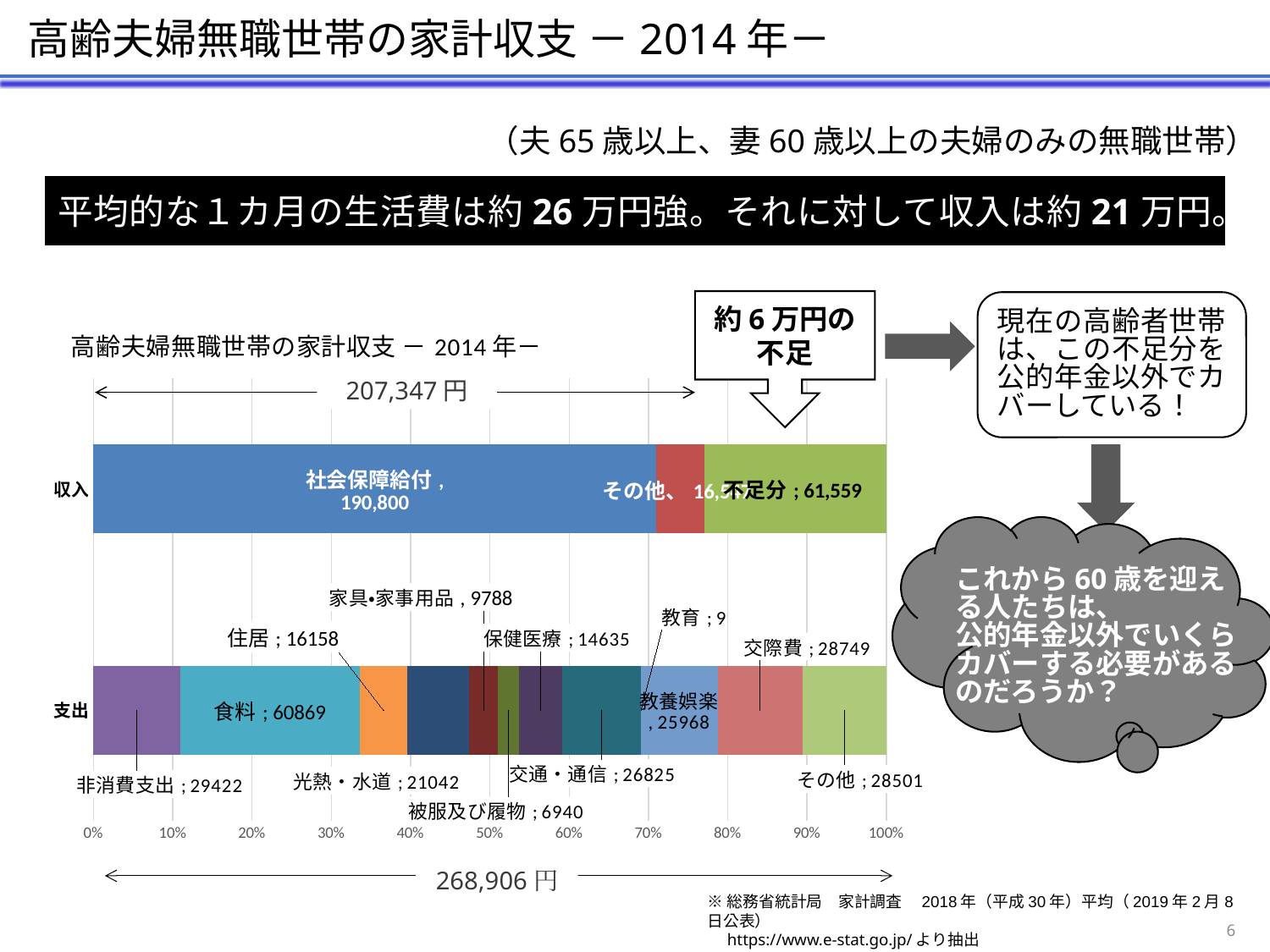
What is the value of 住居 in the 支出 bar? 16158 What total amount is shown for the 収入 bar? 207,347 円 What is the value of 不足分 in the 収入 bar? 61,559 What is the value of 交際費 in the 支出 bar? 28749 What is the value of 社会保障給付 in the 収入 bar? 190,800 What total amount is shown for the 支出 bar? 268,906 円 What is the value of 食料 in the 支出 bar? 60869 What kind of chart is shown on the slide? Stacked bar chart What is the difference between 食料 and 住居 in the 支出 bar? 44711 Which category in the 支出 bar has the largest value? 食料 How many bars (categories) are shown on the vertical axis of the chart? 2 Which is larger in the 支出 bar, 交際費 or その他? 交際費